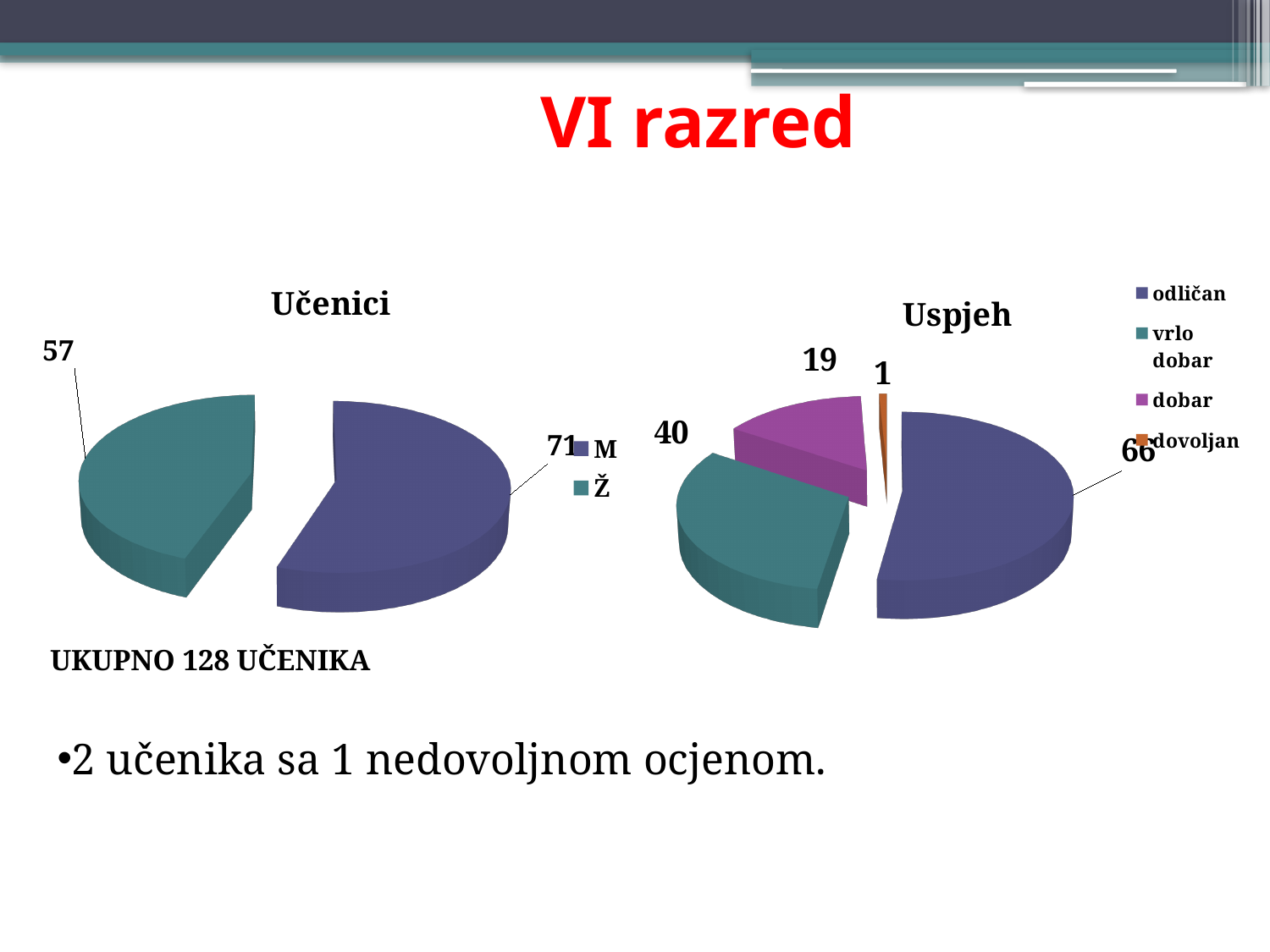
How many categories does the Uspjeh chart show? 4 In the Uspjeh chart, which category has the smallest slice? dovoljan What kind of chart is the Učenici chart? pie chart In the Učenici chart, which is larger, M or Ž? M In the Učenici chart, what is the difference between M and Ž? 14 In the Učenici chart, what is the value for M? 71 In the Uspjeh chart, which category has the largest slice? odličan In the Uspjeh chart, what is the value for vrlo dobar? 40 In the Učenici chart, what is the value for Ž? 57 In the Uspjeh chart, what is the value for dovoljan? 1 In the Uspjeh chart, what is the value for odličan? 66 In the Uspjeh chart, what is the difference between odličan and dobar? 47